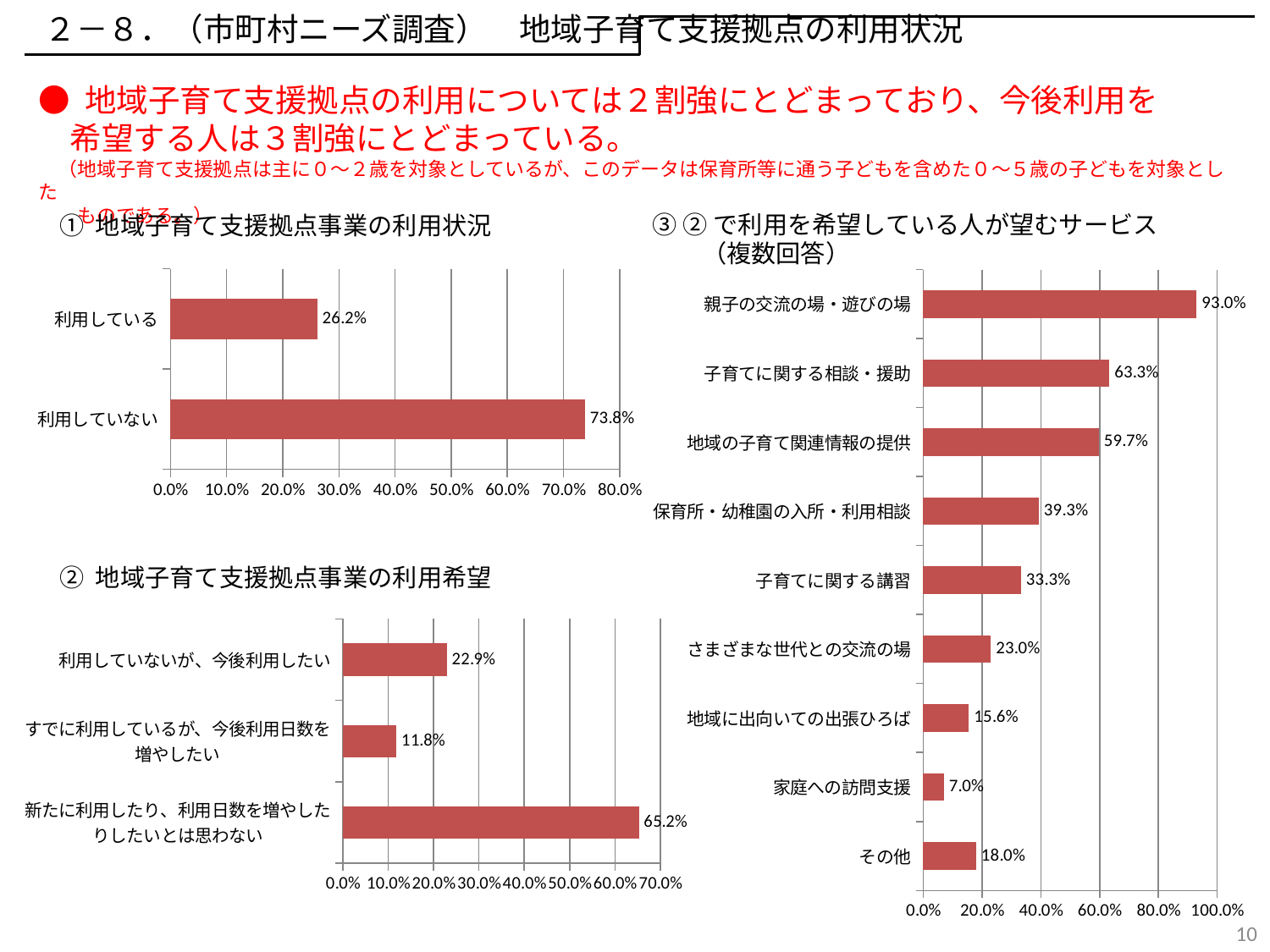
In chart ③ ②で利用を希望している人が望むサービス, what is the value for 親子の交流の場・遊びの場? 93.0% In chart ③ ②で利用を希望している人が望むサービス, which category has the lowest value? 家庭への訪問支援 In chart ① 地域子育て支援拠点事業の利用状況, what is the value for 利用していない? 73.8% In chart ① 地域子育て支援拠点事業の利用状況, what is the value for 利用している? 26.2% In chart ③ ②で利用を希望している人が望むサービス, which is larger: 子育てに関する相談・援助 or 地域の子育て関連情報の提供? 子育てに関する相談・援助 In chart ① 地域子育て支援拠点事業の利用状況, what is the difference between 利用していない and 利用している? 47.6% What type of chart is chart ① 地域子育て支援拠点事業の利用状況? bar chart In chart ② 地域子育て支援拠点事業の利用希望, which category has the lowest value? すでに利用しているが、今後利用日数を増やしたい In chart ② 地域子育て支援拠点事業の利用希望, what is the value for 利用していないが、今後利用したい? 22.9% In chart ③ ②で利用を希望している人が望むサービス, how many categories are shown? 9 In chart ② 地域子育て支援拠点事業の利用希望, how many categories are shown? 3 In chart ③ ②で利用を希望している人が望むサービス, what is the value for その他? 18.0%